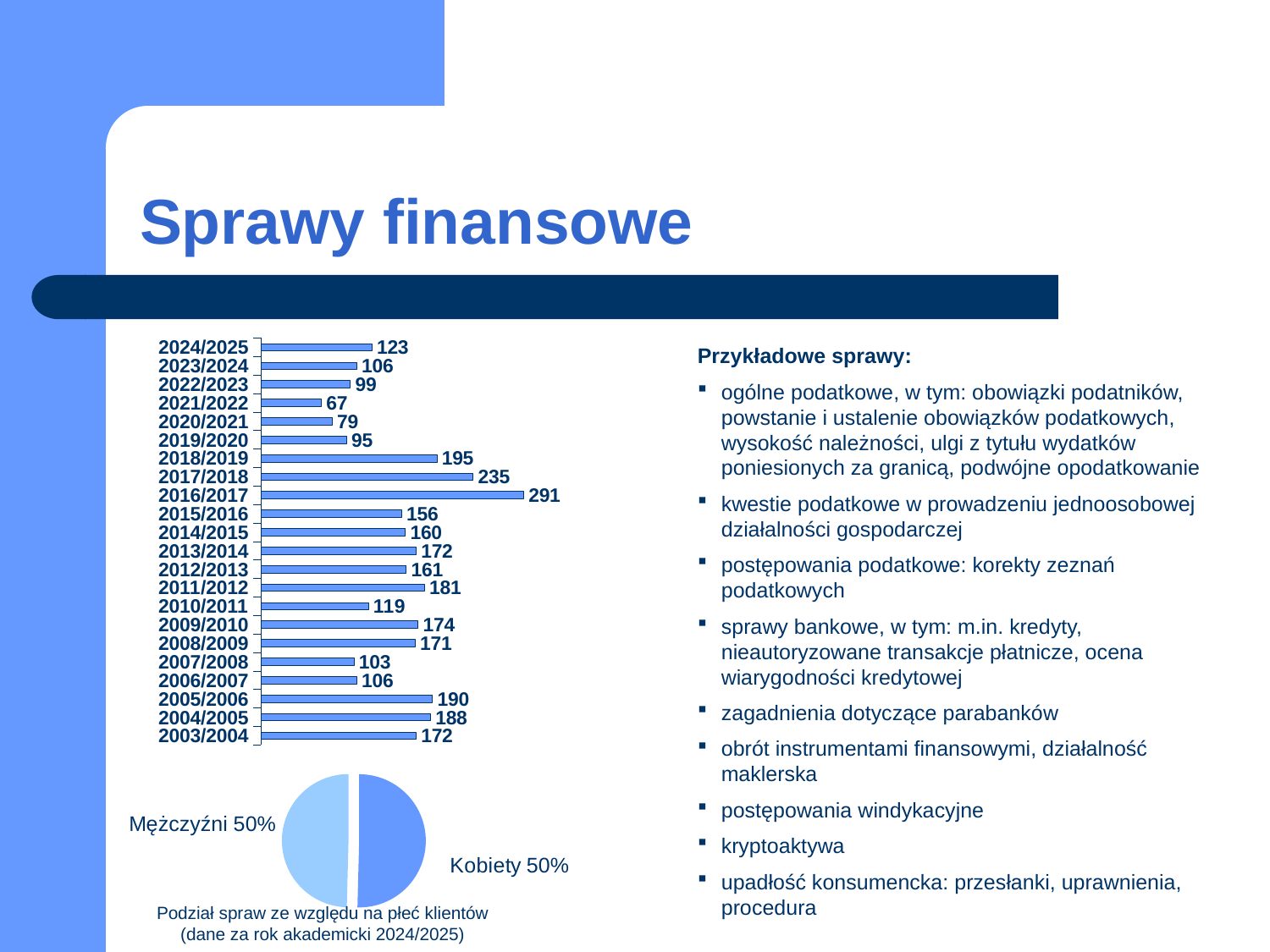
In the bar chart, which academic year has the highest value? 2016/2017 What is the caption under the pie chart? Podział spraw ze względu na płeć klientów (dane za rok akademicki 2024/2025) In the bar chart, which academic year has the lowest value? 2021/2022 In the bar chart, what is the value for 2024/2025? 123 In the bar chart, which is larger: the value for 2018/2019 or the value for 2005/2006? 2018/2019 In the bar chart, what is the difference between the values for 2023/2024 and 2022/2023? 7 In the bar chart, what is the difference between the values for 2016/2017 and 2017/2018? 56 In the pie chart at the bottom of the slide, what share is labelled Kobiety? 50% What kind of chart is the upper chart on the slide? Bar chart What kind of chart is the lower chart on the slide? Pie chart In the bar chart, what is the value for 2017/2018? 235 In the bar chart, how many academic years are shown? 22